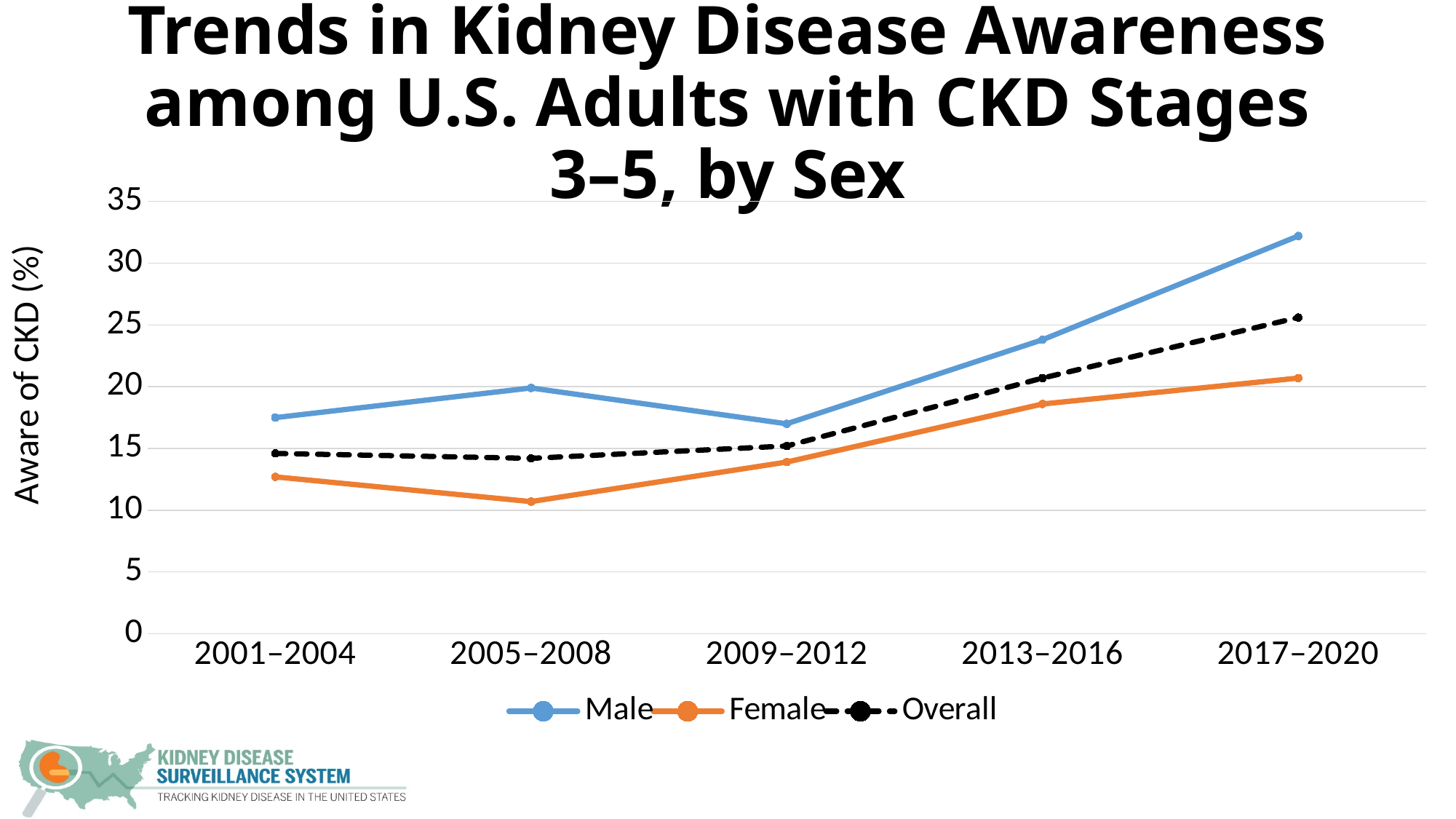
Which series is drawn with a dashed line? Overall Is the Female value for 2005–2008 greater or less than 15? less How many time periods are plotted along the x axis? 5 How many series does the legend list? 3 Does the Female series rise or fall from 2009–2012 to 2017–2020? Rise Is the Overall value for 2009–2012 greater or less than 20? less Is the Male value for 2017–2020 greater or less than 30? greater In which period is the Female series at its lowest? 2005–2008 In which period is the Male series at its highest? 2017–2020 What kind of chart is shown on the slide? Line chart In 2017–2020, which is higher: the Male value or the Female value? Male What is the label on the y axis? Aware of CKD (%)